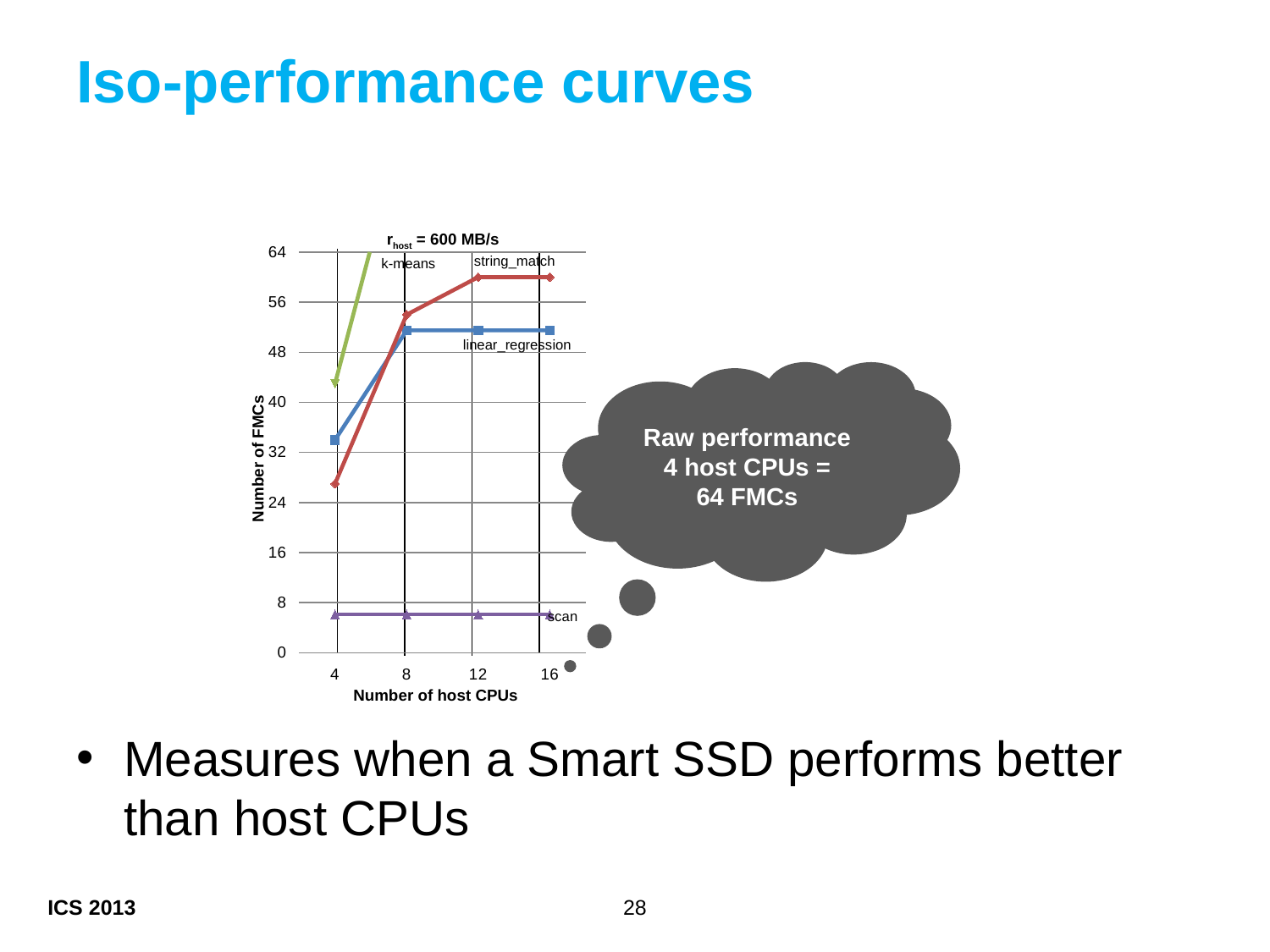
What kind of chart is shown on the slide? line chart Is the value for string_match at 16 host CPUs greater or less than 56? greater Is the value for linear_regression at 16 host CPUs greater or less than 48? greater How many host CPU values are marked on the x axis of the chart? 4 Does the scan line rise, fall, or stay flat as the number of host CPUs increases? stays flat How many labelled lines (series) does the chart show? 4 What is the label of the y axis of the chart? Number of FMCs At 4 host CPUs, which series is higher: k-means or string_match? k-means At 16 host CPUs, which series is higher: string_match or linear_regression? string_match Which series has the lowest number of FMCs across all host CPU counts? scan Is the value for scan at 4 host CPUs greater or less than 8? less